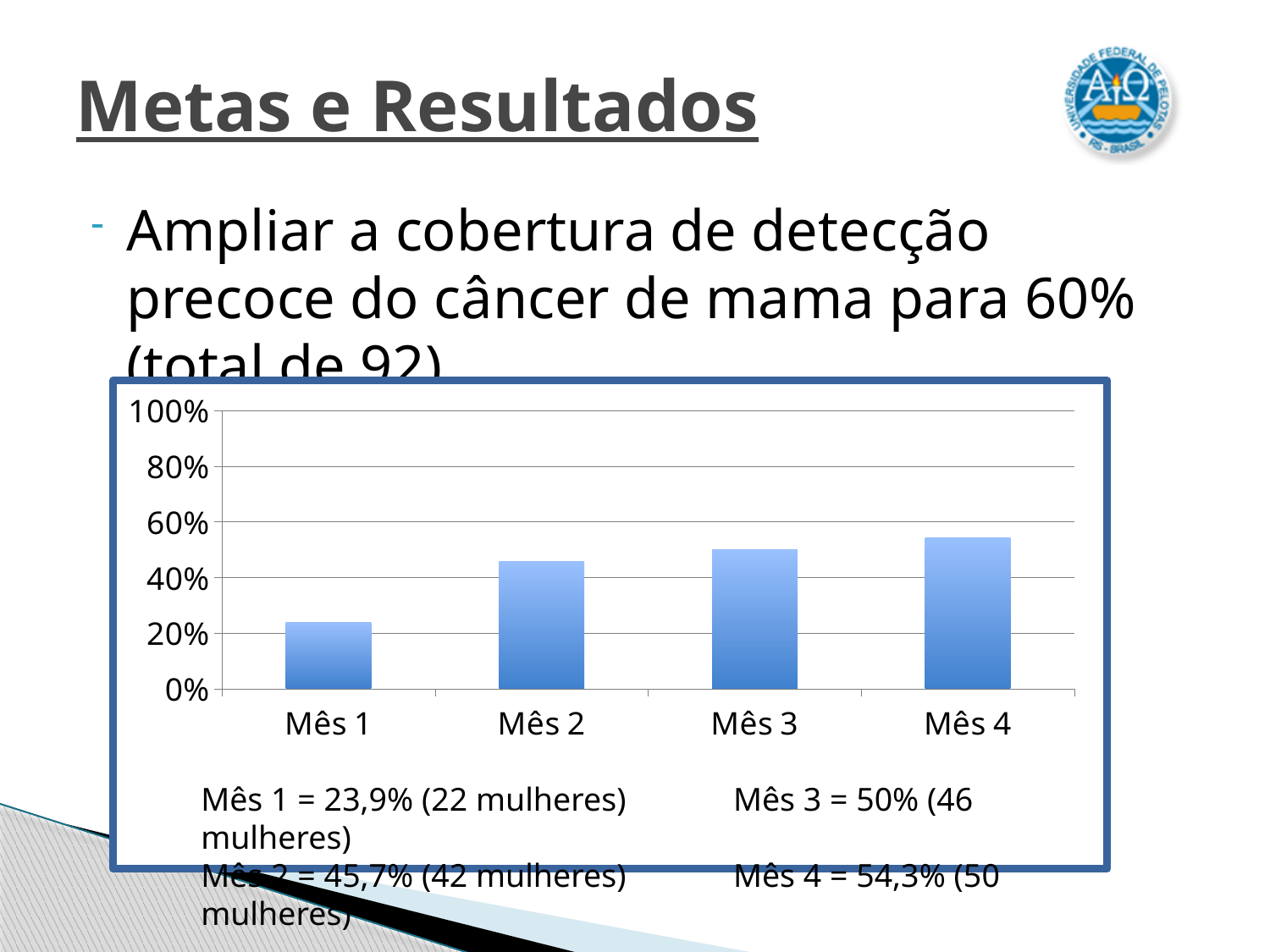
What is the difference between the values for Mês 4 and Mês 1? 30,4% What kind of chart is shown on the slide? bar chart How many categories (months) are plotted on the chart? 4 Which month has the highest value on the chart? Mês 4 Do the values rise or fall from Mês 1 to Mês 4? rise Is the value for Mês 4 greater or less than 60%? less What is the value for Mês 2? 45,7% What is the value for Mês 4? 54,3% What is the value for Mês 1? 23,9% What is the value for Mês 3? 50% Is the value for Mês 1 greater or less than 40%? less Which month has the lowest value on the chart? Mês 1